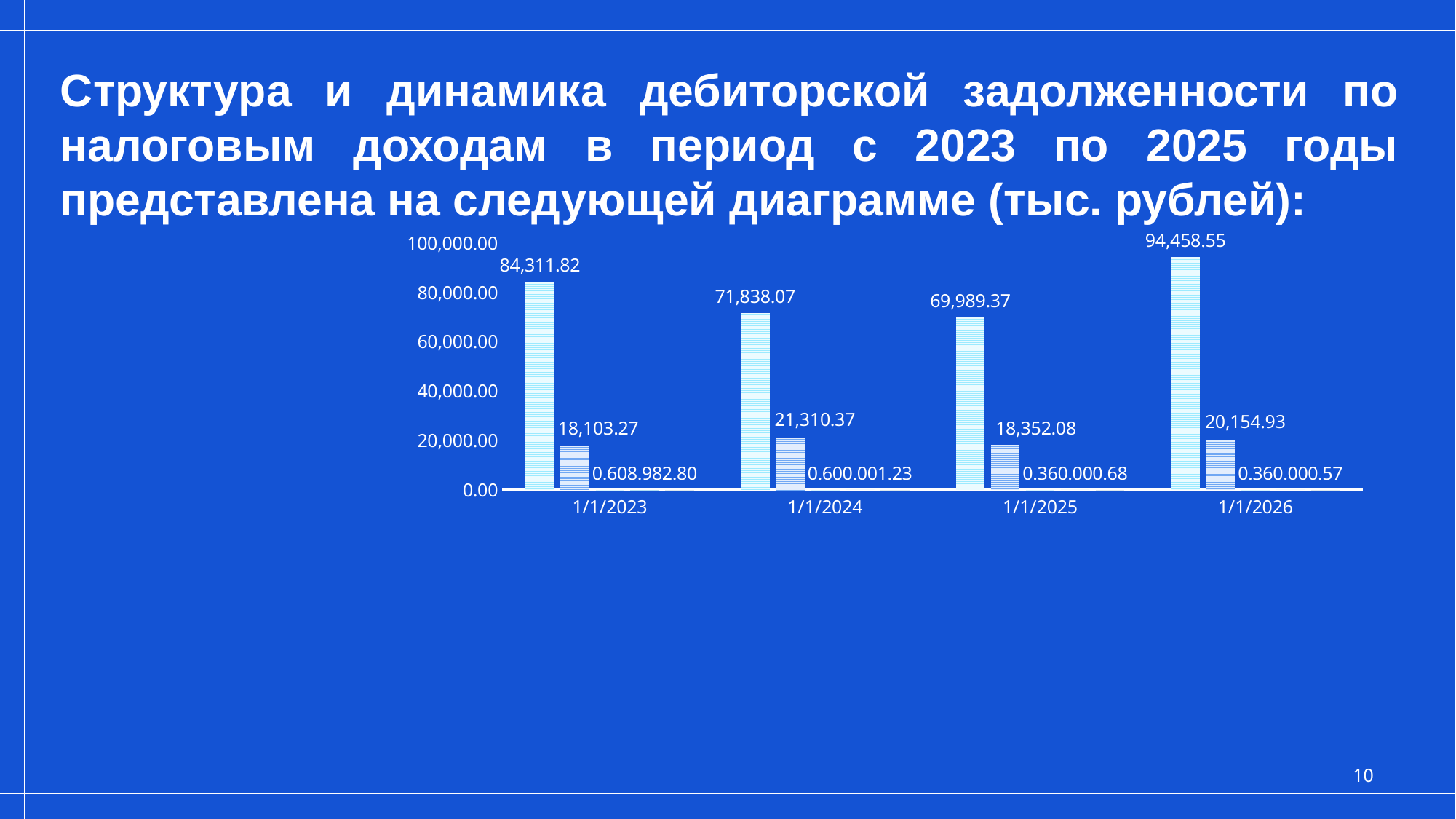
Is the value of the tallest bar for 1/1/2024 greater or less than 80,000.00? less How many dates are shown along the x axis of the chart? 4 What is the value of the second (middle) bar for 1/1/2024? 21,310.37 What is the value of the tallest bar for 1/1/2023? 84,311.82 What is the difference between the tallest bar for 1/1/2026 and the tallest bar for 1/1/2023? 10,146.73 What is the value of the tallest bar for 1/1/2025? 69,989.37 For which date is the tallest bar the lowest? 1/1/2025 What kind of chart is shown on the slide? bar chart Which date has the larger second (middle) bar, 1/1/2024 or 1/1/2026? 1/1/2024 For which date is the tallest bar the highest? 1/1/2026 What is the highest tick value shown on the y axis of the chart? 100,000.00 For which date is the second (middle) bar the highest? 1/1/2024